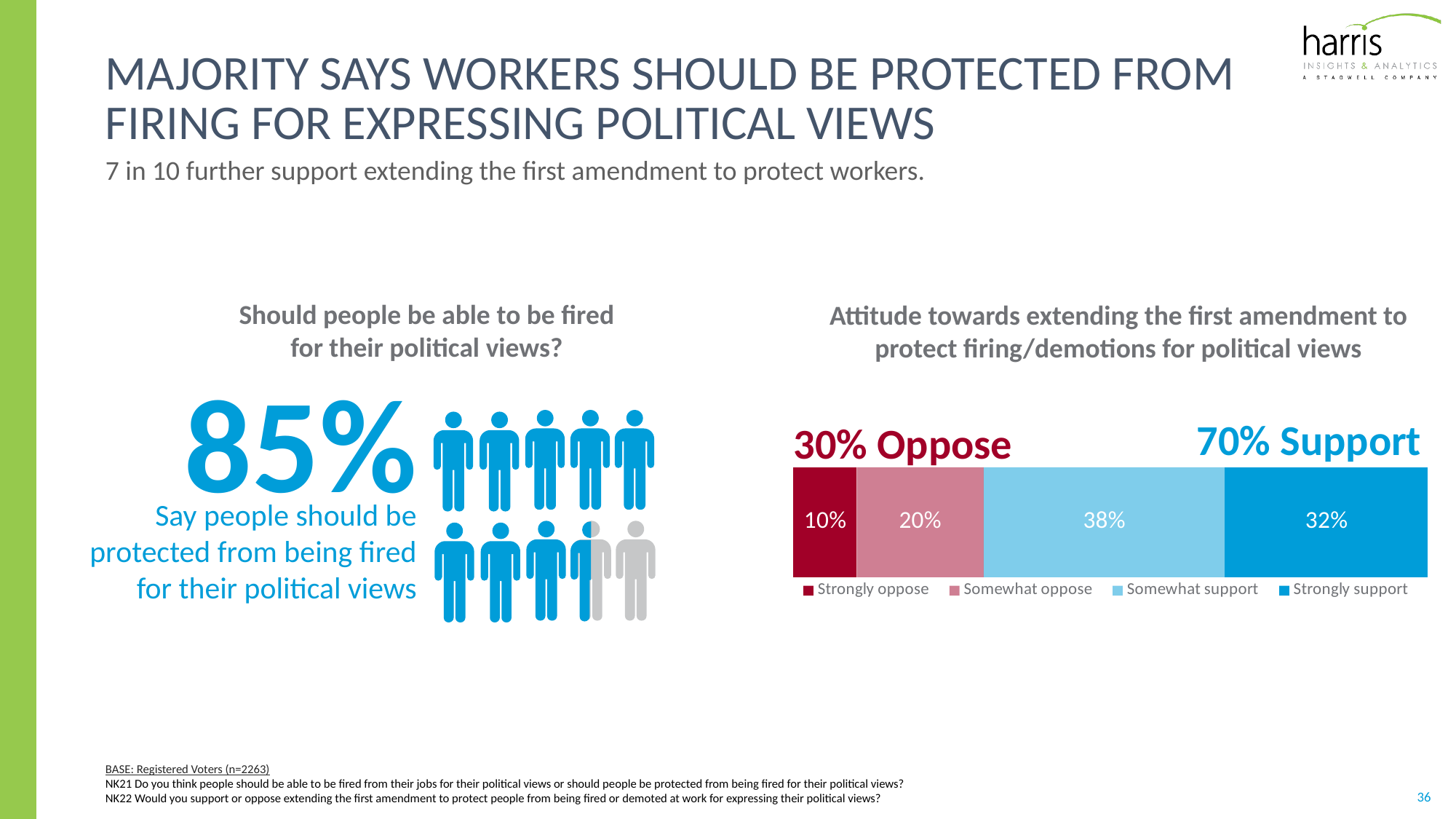
In the chart titled 'Attitude towards extending the first amendment to protect firing/demotions for political views', which is larger: somewhat oppose or strongly support? Strongly support In the chart titled 'Attitude towards extending the first amendment to protect firing/demotions for political views', what percentage strongly oppose? 10% In the chart titled 'Attitude towards extending the first amendment to protect firing/demotions for political views', what is the difference between the somewhat support and strongly support percentages? 6% In the graphic titled 'Should people be able to be fired for their political views?', what percentage say people should be protected from being fired for their political views? 85% In the chart titled 'Attitude towards extending the first amendment to protect firing/demotions for political views', what percentage somewhat support? 38% In the chart titled 'Attitude towards extending the first amendment to protect firing/demotions for political views', how many categories does the legend list? 4 In the chart titled 'Attitude towards extending the first amendment to protect firing/demotions for political views', what percentage strongly support? 32% In the chart titled 'Attitude towards extending the first amendment to protect firing/demotions for political views', what is the total percentage that support (somewhat plus strongly)? 70% In the chart titled 'Attitude towards extending the first amendment to protect firing/demotions for political views', which response category has the largest share? Somewhat support In the chart titled 'Attitude towards extending the first amendment to protect firing/demotions for political views', which response category has the smallest share? Strongly oppose In the chart titled 'Attitude towards extending the first amendment to protect firing/demotions for political views', what percentage somewhat oppose? 20% What kind of chart is shown under the title 'Attitude towards extending the first amendment to protect firing/demotions for political views'? Stacked bar chart